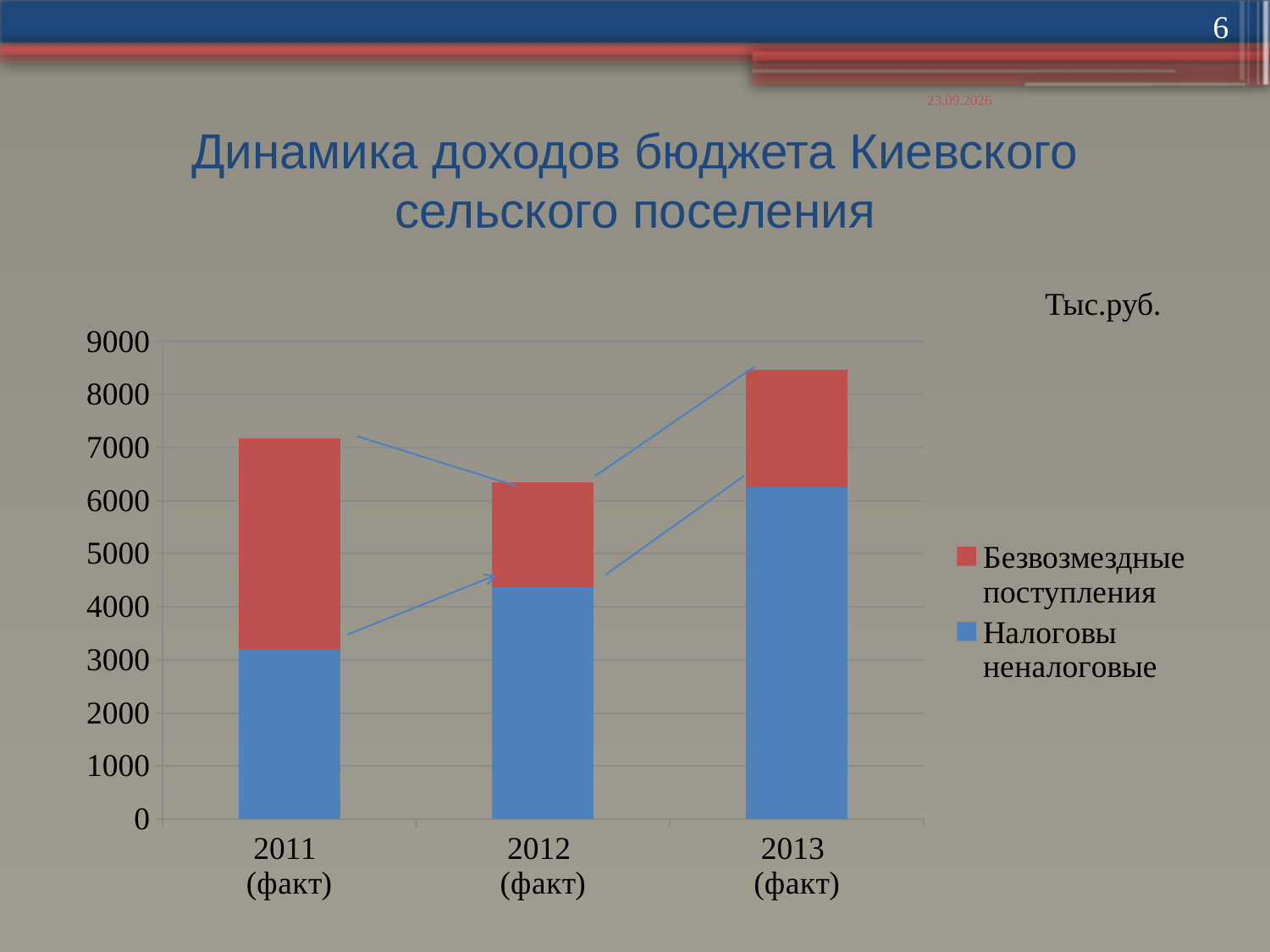
Is the total bar for 2012 (факт) greater or less than 7000? less Which year has the tallest total bar? 2013 (факт) Which year has the largest value for Безвозмездные поступления? 2011 (факт) Which year has the shortest total bar? 2012 (факт) In 2011 (факт), which is larger: Безвозмездные поступления or Налоговы неналоговые? Безвозмездные поступления How many years (categories) are shown on the x axis? 3 Is the total bar for 2013 (факт) greater or less than 8000? greater Is the value for Налоговы неналоговые in 2011 (факт) greater or less than 3000? greater How many series does the legend list? 2 Which year has the smallest value for Налоговы неналоговые? 2011 (факт) What kind of chart is shown on the slide? Stacked bar chart Does the value for Налоговы неналоговые rise or fall from 2011 to 2013? rise